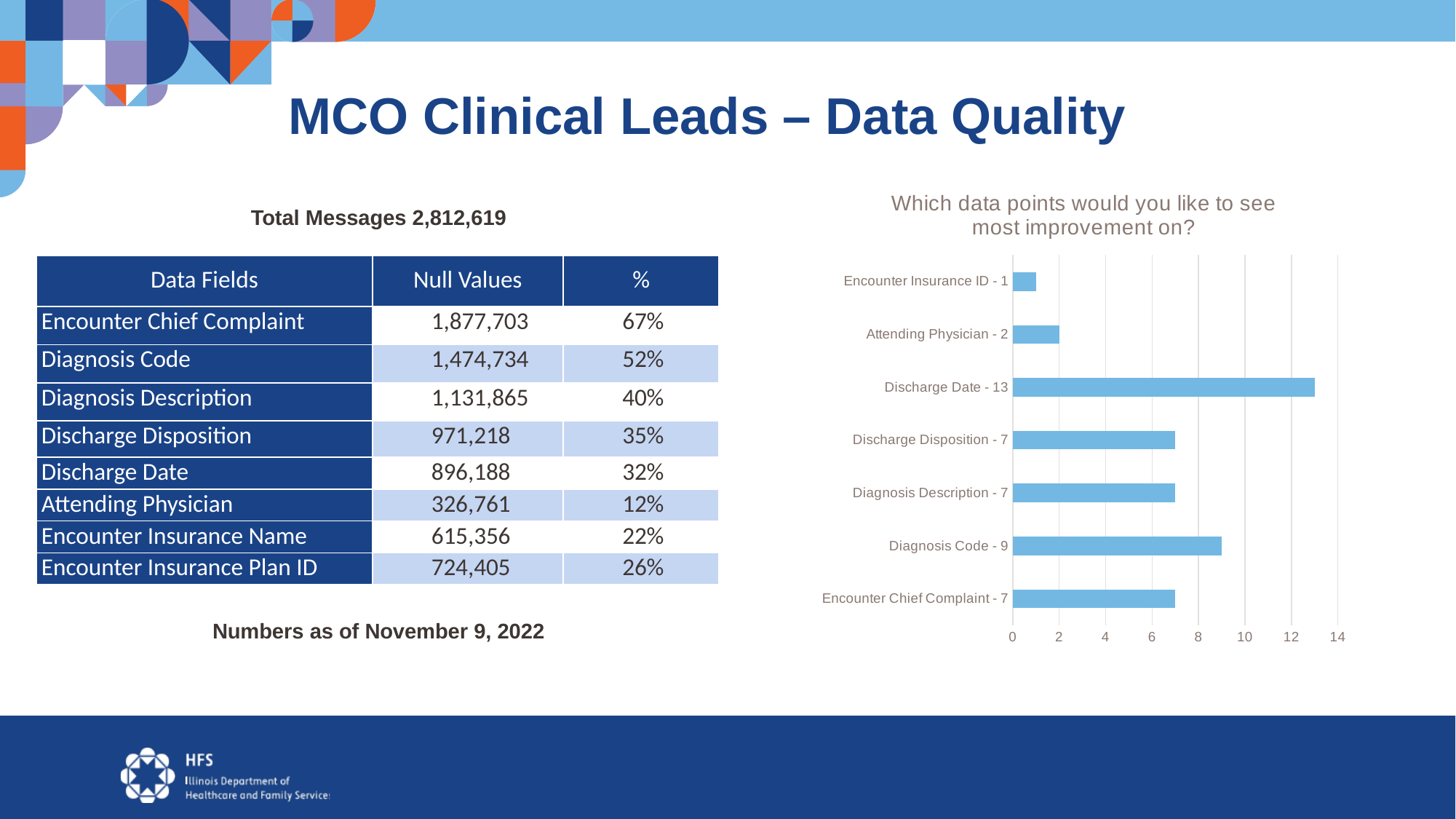
What is the value for Attending Physician in the chart? 2 Which category has the highest value in the chart? Discharge Date What is the value for Encounter Insurance ID in the chart? 1 How many categories are plotted in the chart? 7 What is the value for Diagnosis Code in the chart? 9 Which is larger, the value for Diagnosis Code or the value for Discharge Disposition? Diagnosis Code What is the difference between the values for Discharge Date and Diagnosis Code? 4 What type of chart is shown on the slide? bar chart Is the value for Discharge Date greater or less than 12? greater What is the title of the chart? Which data points would you like to see most improvement on? Which category has the lowest value in the chart? Encounter Insurance ID What is the value for Discharge Date in the chart? 13